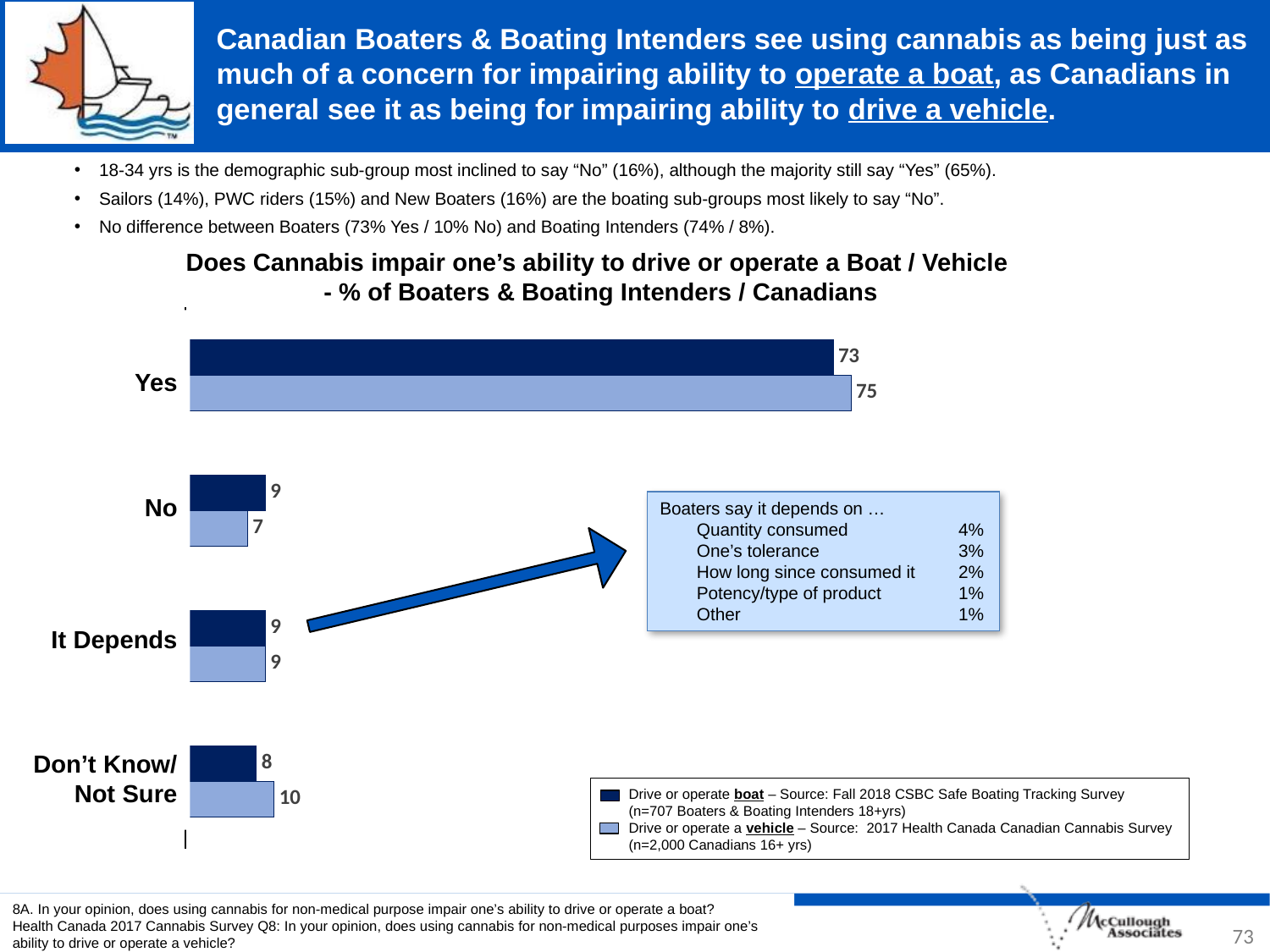
What type of chart is shown on the slide? Bar chart What is the value for "Don't Know/Not Sure" in the "Drive or operate boat" series? 8 Which colour represents the "Drive or operate boat" series in the chart? Dark blue Which response category has the highest value for the "Drive or operate boat" series? Yes How many response categories are shown in the chart? 4 For the "No" response, which series has the larger value: "Drive or operate boat" or "Drive or operate a vehicle"? Drive or operate boat What percentage of Boaters & Boating Intenders say "Yes", cannabis impairs one's ability to drive or operate a boat? 73 What is the value for "No" in the "Drive or operate a vehicle" series? 7 What is the difference between the "Drive or operate a vehicle" and "Drive or operate boat" values for "Don't Know/Not Sure"? 2 What percentage of Canadians say "Yes", cannabis impairs one's ability to drive or operate a vehicle? 75 How many series does the chart's legend list? 2 Which response category has the lowest value for the "Drive or operate a vehicle" series? No